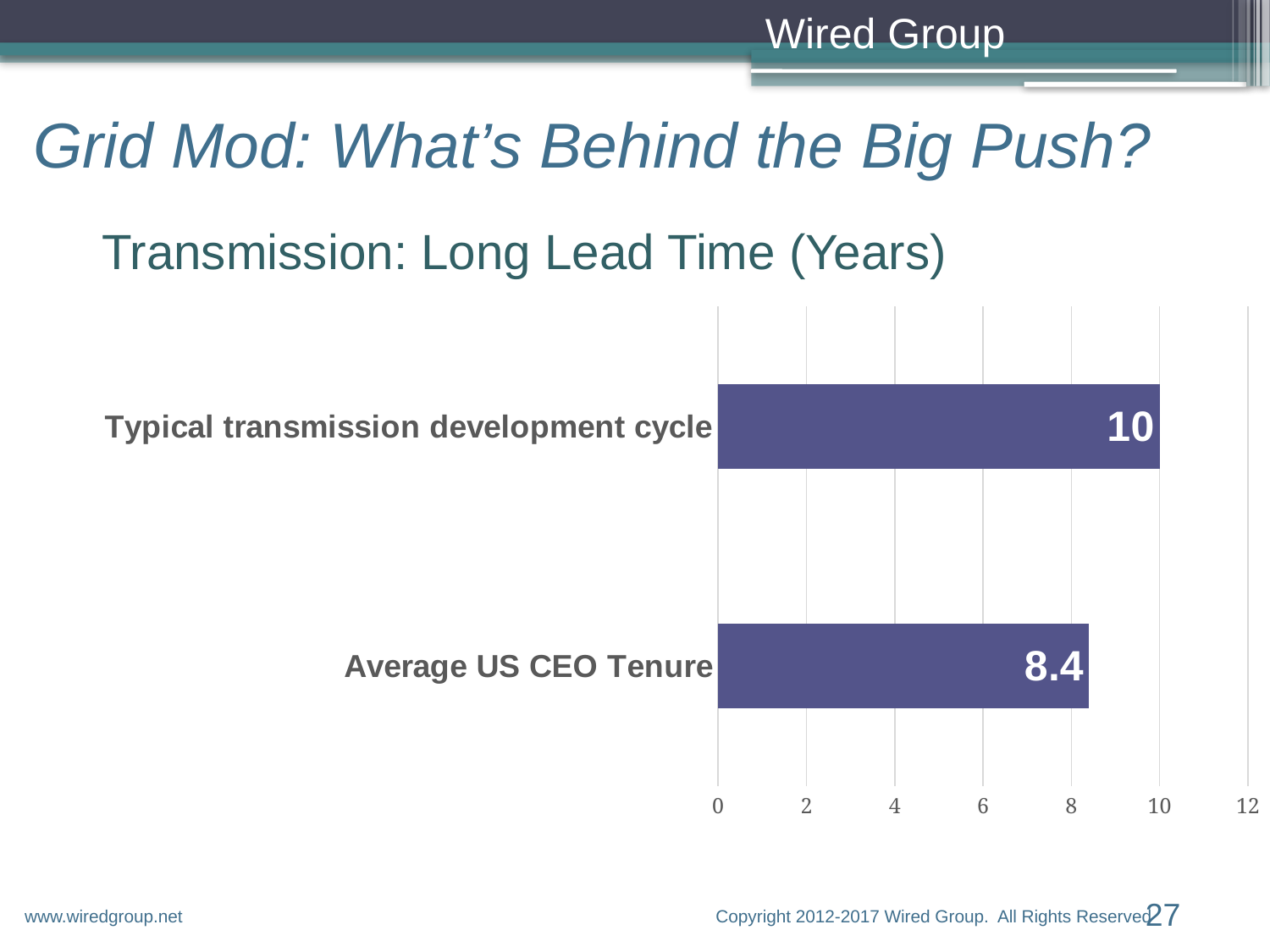
How many categories are shown in the chart? 2 What is the value for Average US CEO Tenure? 8.4 What is the heading above the chart? Transmission: Long Lead Time (Years) Is the value for Typical transmission development cycle greater or less than 12? less What is the maximum value shown on the x axis? 12 What is the difference between the Typical transmission development cycle and Average US CEO Tenure values? 1.6 What kind of chart is shown on the slide? Bar chart What is the value for Typical transmission development cycle? 10 Which is larger: Typical transmission development cycle or Average US CEO Tenure? Typical transmission development cycle Is the value for Average US CEO Tenure greater or less than 8? greater Which category has the lowest value? Average US CEO Tenure Which category has the highest value? Typical transmission development cycle